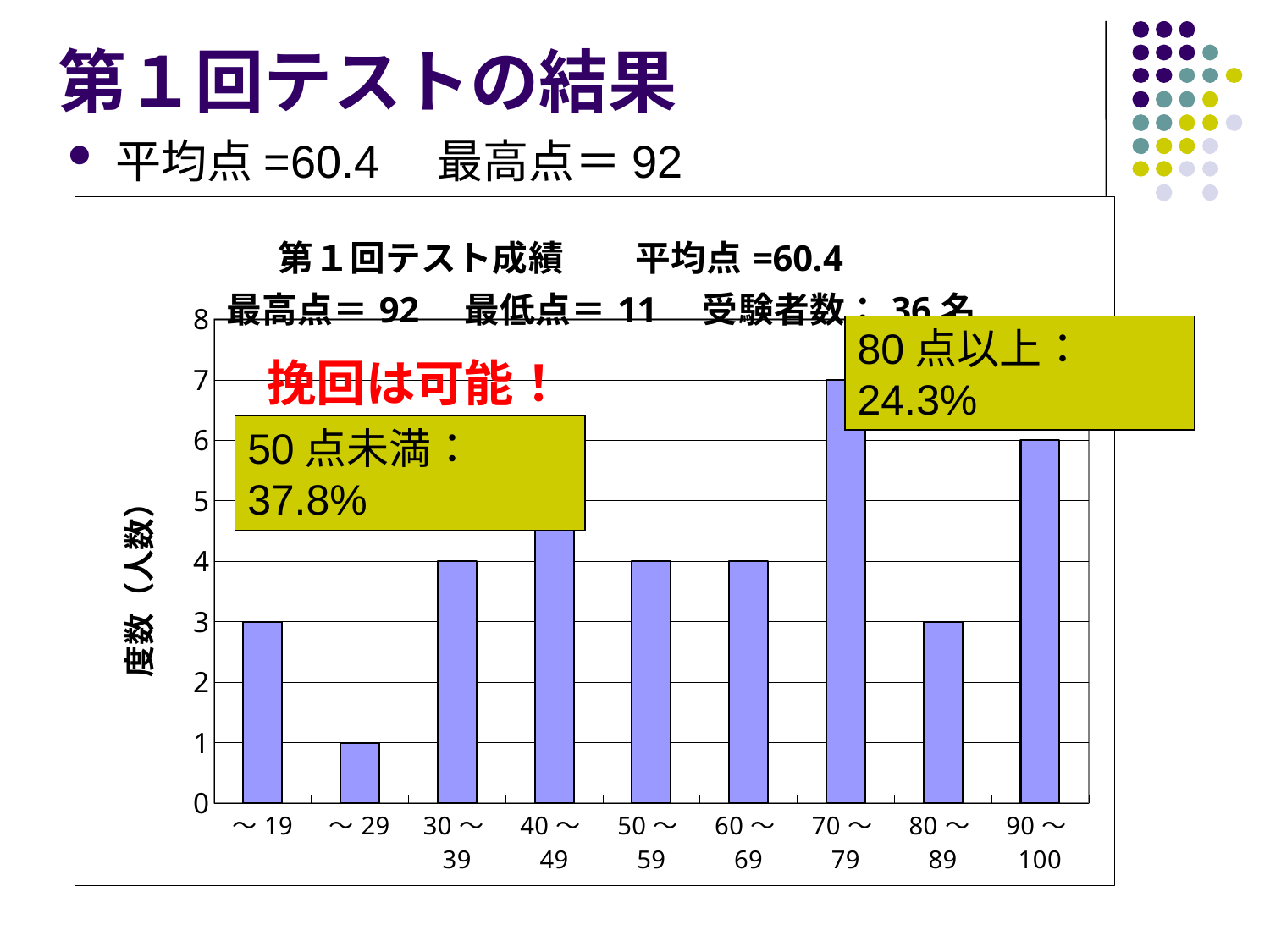
What is the label of the y axis? 度数（人数） How many score ranges (categories) are shown on the x axis? 9 Which score range has the highest frequency? 70～79 What is the difference in frequency between the 70～79 range and the 80～89 range? 4 What is the frequency for the 90～100 score range? 6 Is the frequency for the 40～49 range greater or less than 4? greater Which has a higher frequency, the 90～100 range or the 80～89 range? 90～100 What is the frequency (度数) for the 70～79 score range? 7 What is the frequency for the ～19 score range? 3 Which score range has the lowest frequency? ～29 What is the frequency for the 80～89 score range? 3 What kind of chart is shown on the slide? bar chart